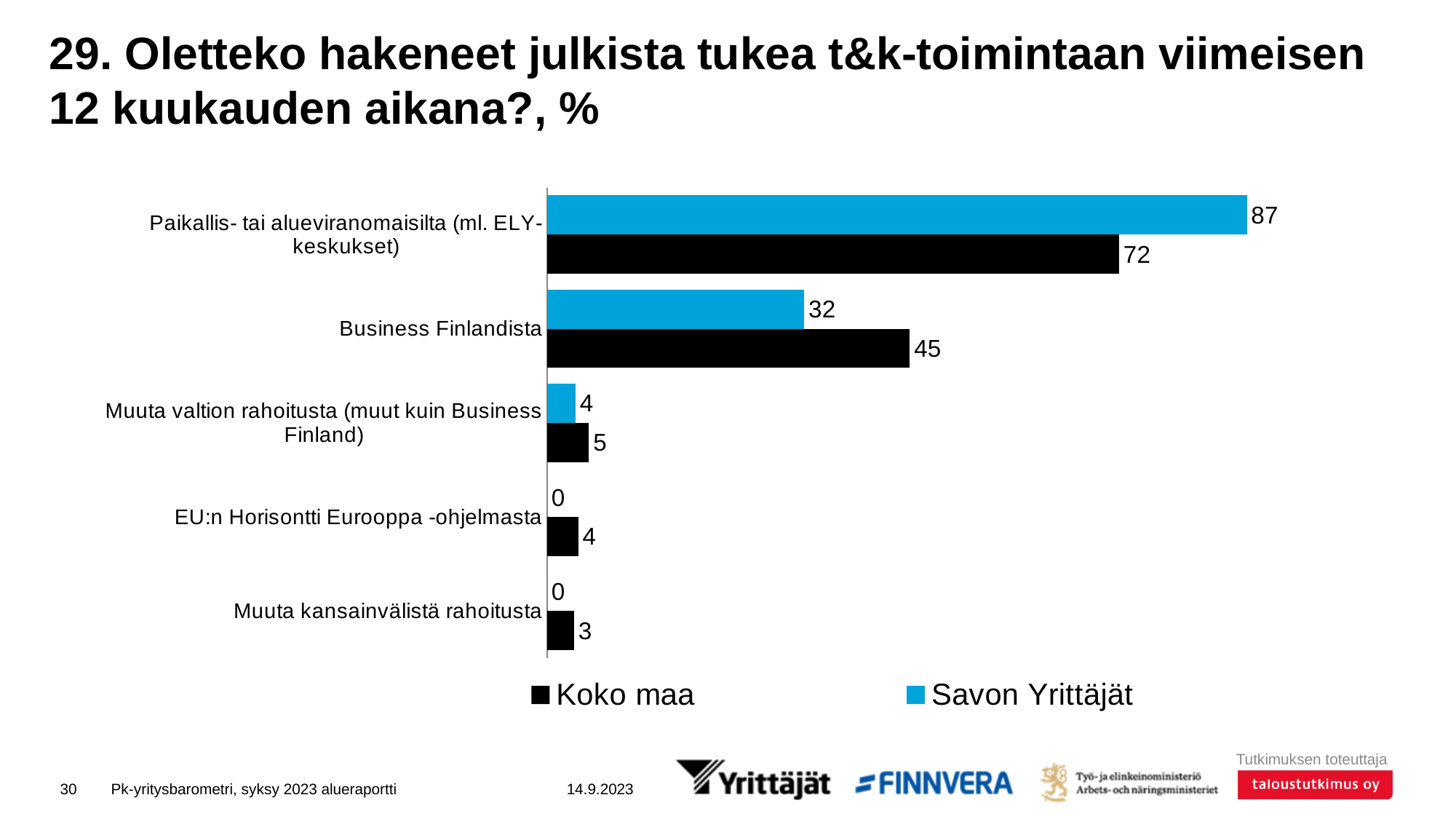
What is the value for Koko maa for 'Business Finlandista'? 45 What is the value for Savon Yrittäjät for 'Paikallis- tai alueviranomaisilta (ml. ELY-keskukset)'? 87 Which category has the lowest value for Koko maa? Muuta kansainvälistä rahoitusta How many series does the legend list? 2 For 'Business Finlandista', which series has the larger value, Koko maa or Savon Yrittäjät? Koko maa What is the value for Koko maa for 'Muuta kansainvälistä rahoitusta'? 3 How many categories are shown in the chart? 5 What is the difference between the Savon Yrittäjät and Koko maa values for 'Paikallis- tai alueviranomaisilta (ml. ELY-keskukset)'? 15 What kind of chart is shown on the slide? Bar chart What is the difference between the Koko maa and Savon Yrittäjät values for 'Business Finlandista'? 13 What is the value for Savon Yrittäjät for 'EU:n Horisontti Eurooppa -ohjelmasta'? 0 Which category has the highest value for Koko maa? Paikallis- tai alueviranomaisilta (ml. ELY-keskukset)